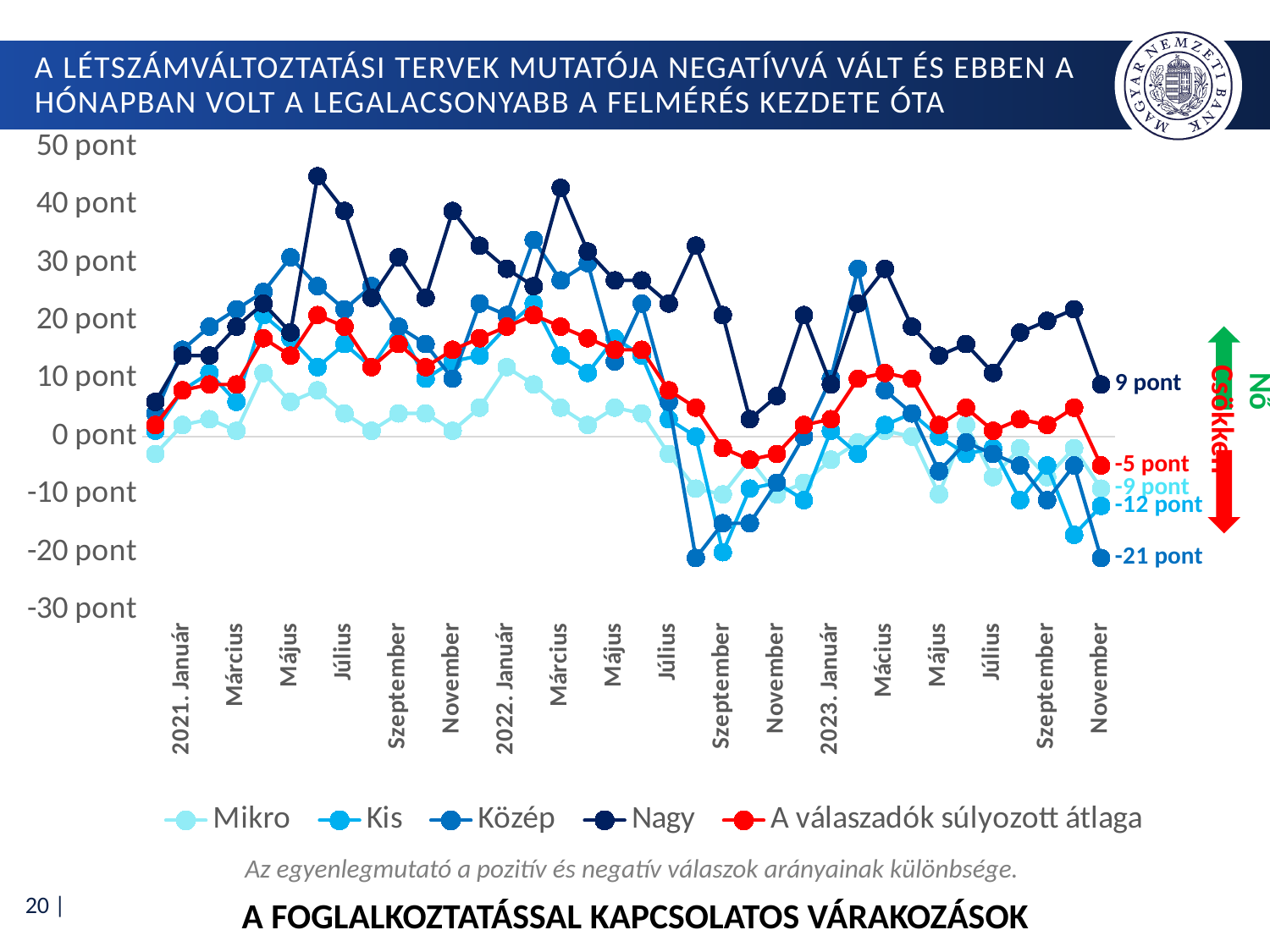
How many series does the legend list? 5 Which series has the highest value in November 2023? Nagy What is the value of the Közép series in November 2023? -21 pont Which series has the lowest value in November 2023? Közép What is the value of the Mikro series in November 2023? -9 pont What kind of chart is shown on the slide? line chart What is the difference between the Nagy and Közép values in November 2023? 30 pont What is the value of the Nagy series in November 2023? 9 pont What is the value of 'A válaszadók súlyozott átlaga' in November 2023? -5 pont What is the value of the Kis series in November 2023? -12 pont In November 2023, which is larger: the Mikro value or the Kis value? Mikro